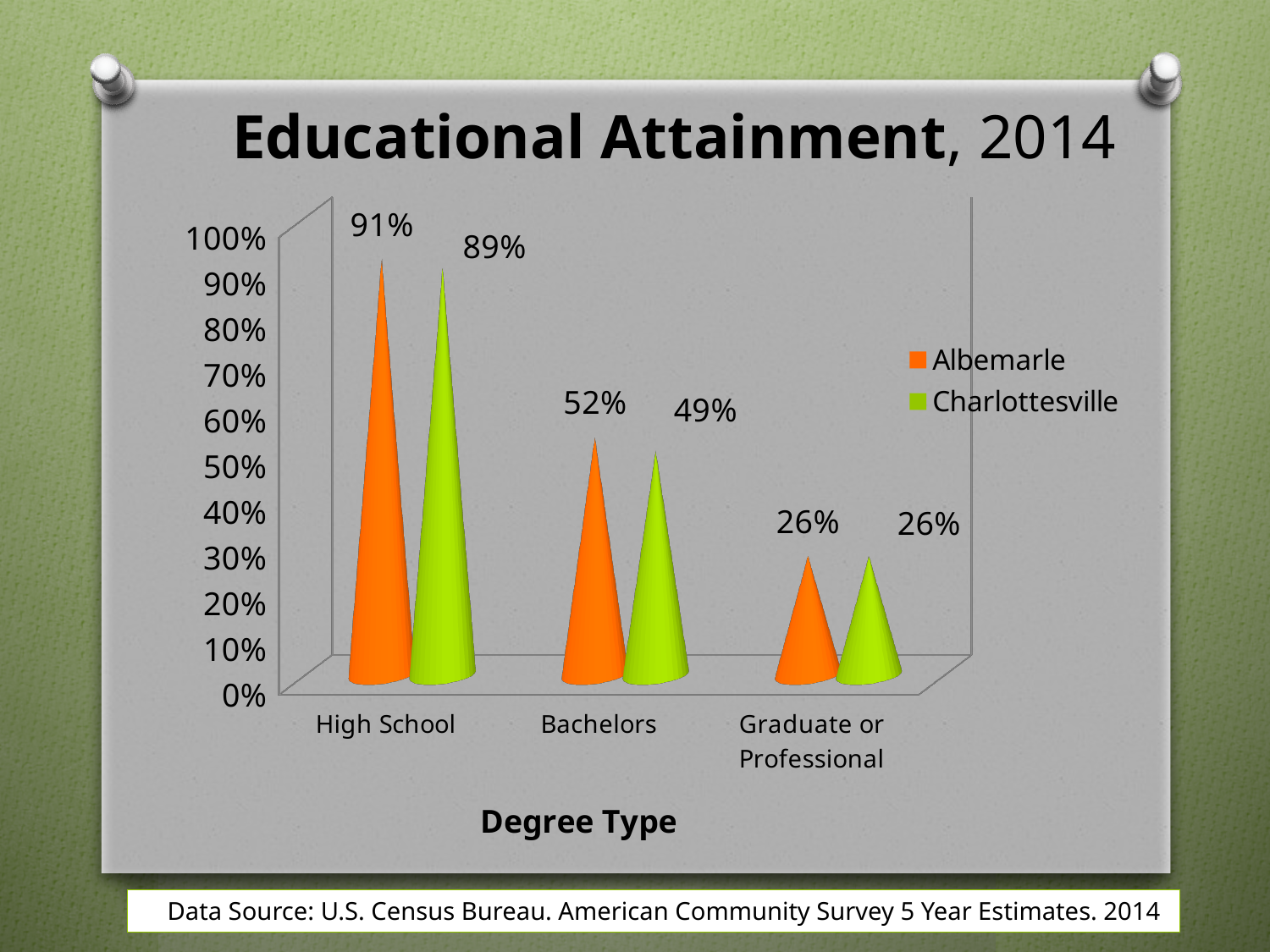
What kind of chart is shown on the slide? Bar chart Which degree type has the lowest value for Albemarle? Graduate or Professional What is the value for Albemarle for High School? 91% How many degree types are shown on the x axis? 3 Which degree type has the highest value for Charlottesville? High School What is the difference between the Albemarle values for High School and Bachelors? 39% Do the Charlottesville values rise or fall from High School to Graduate or Professional? Fall How many series does the legend list? 2 What is the value for Albemarle for Graduate or Professional? 26% What is the difference between Albemarle and Charlottesville for Bachelors? 3% What is the value for Charlottesville for Bachelors? 49% Which is larger for High School, Albemarle or Charlottesville? Albemarle